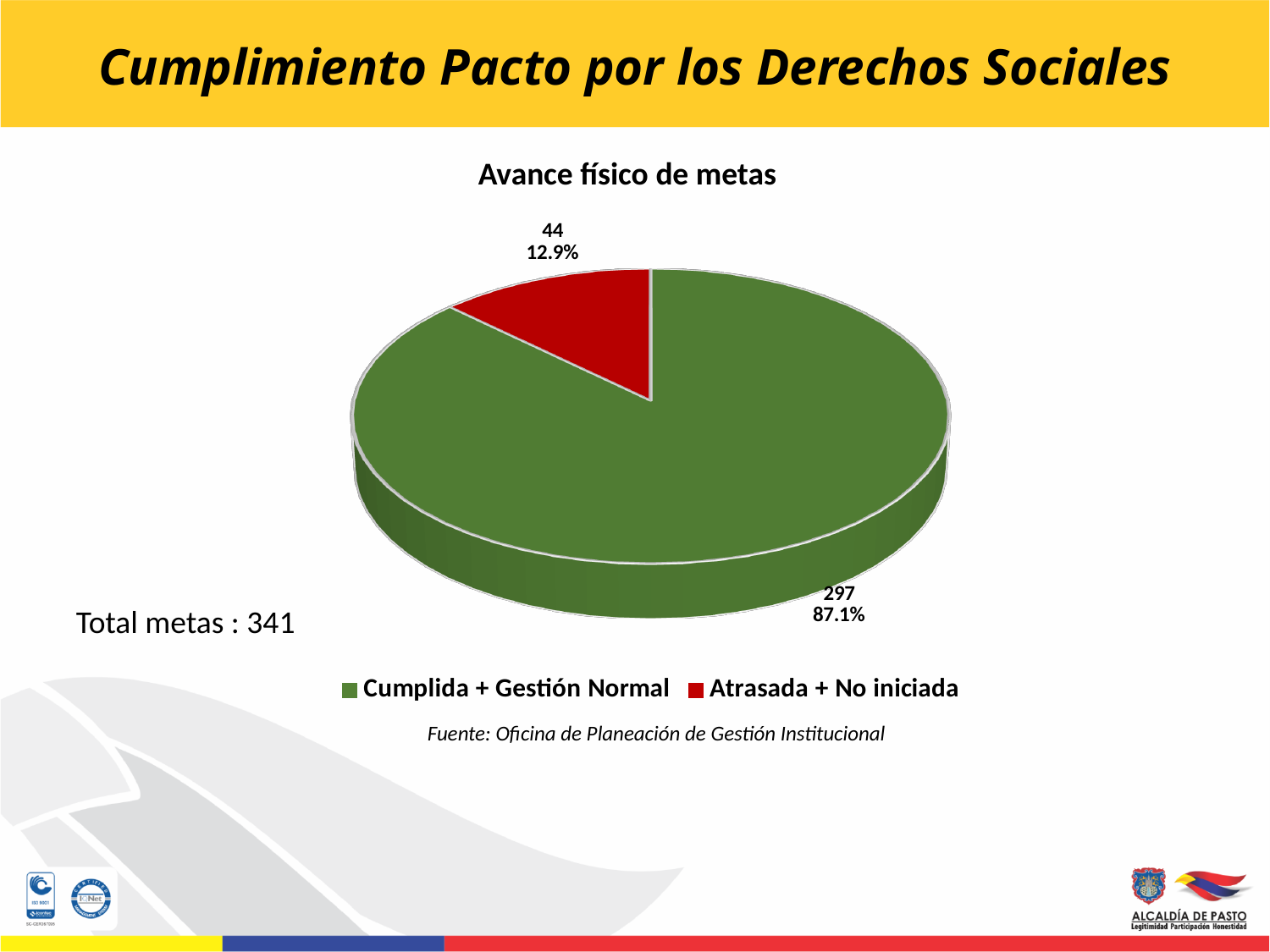
How many slices does the pie chart have? 2 What is the difference between the values for Cumplida + Gestión Normal and Atrasada + No iniciada? 253 How many entries does the legend list? 2 What is the title of the chart? Avance físico de metas What colour is the slice for Atrasada + No iniciada? red Which category has the largest slice? Cumplida + Gestión Normal Which category has the smallest slice? Atrasada + No iniciada What share of the pie does Cumplida + Gestión Normal represent? 87.1% What is the value for Cumplida + Gestión Normal? 297 What share of the pie does Atrasada + No iniciada represent? 12.9% What is the value for Atrasada + No iniciada? 44 What kind of chart is shown on the slide? pie chart